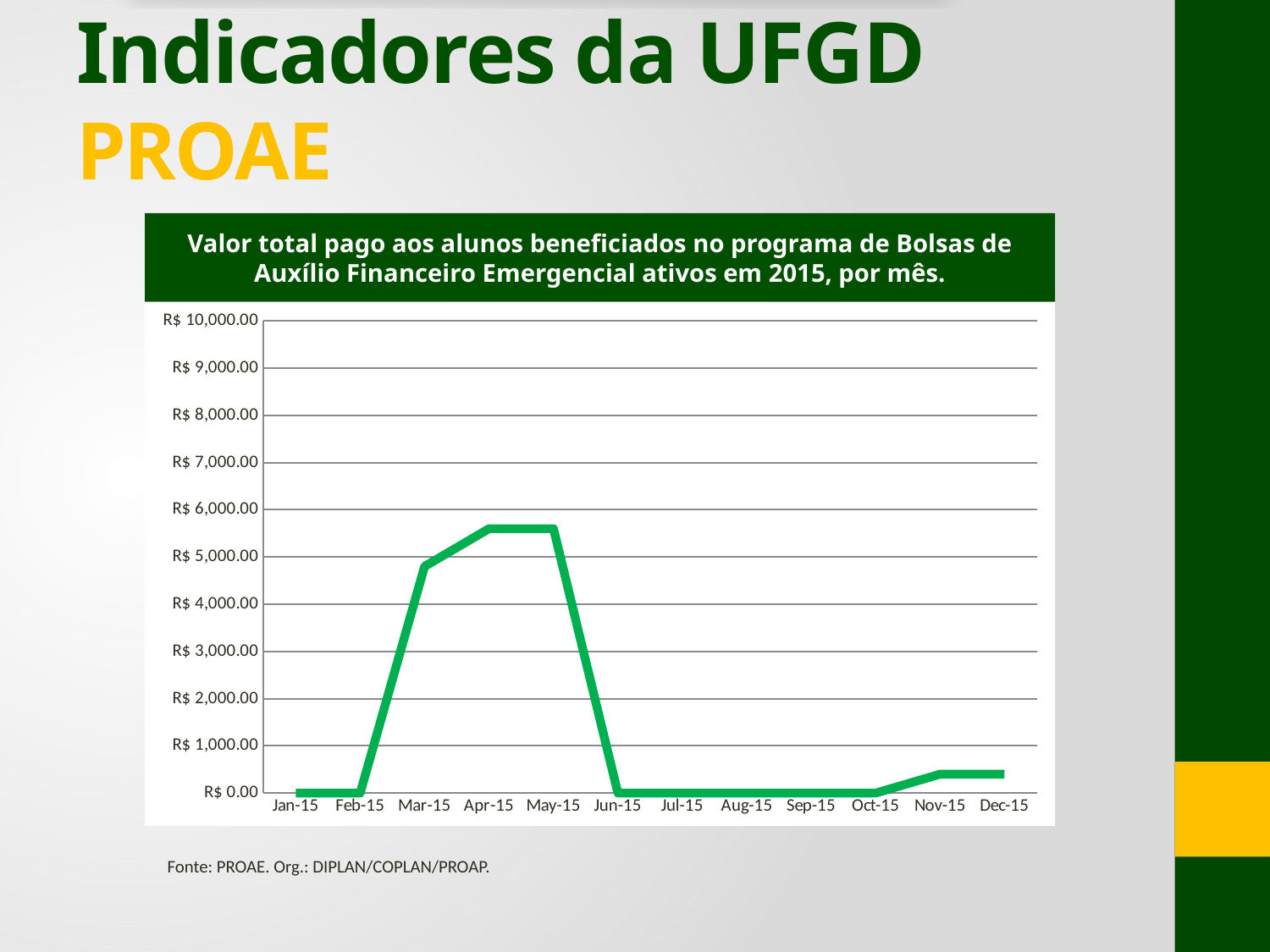
Is the value for Mar-15 greater or less than R$ 4,000.00? greater How many months are plotted along the x axis of the chart? 12 Is the value for Nov-15 greater or less than R$ 1,000.00? less Is the value for Apr-15 greater or less than R$ 5,000.00? greater What is the value for Jan-15? R$ 0.00 What kind of chart is shown on the slide? line chart Which is larger, the value for Mar-15 or the value for Dec-15? Mar-15 What is the title of the chart? Valor total pago aos alunos beneficiados no programa de Bolsas de Auxílio Financeiro Emergencial ativos em 2015, por mês. Does the value rise or fall from May-15 to Jun-15? fall What is the value for Jun-15? R$ 0.00 What is the value for Sep-15? R$ 0.00